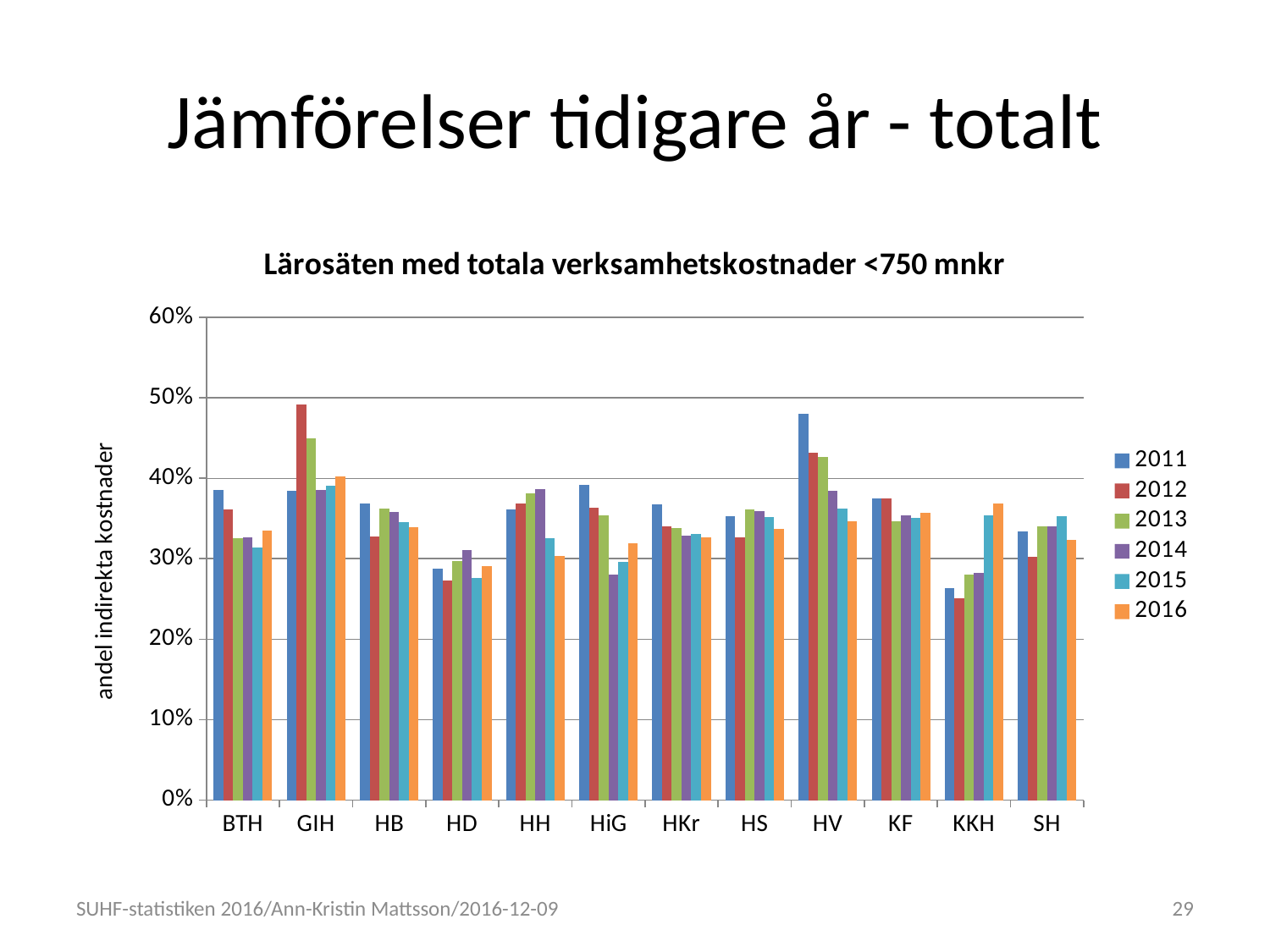
Is the 2012 value for GIH greater or less than 40%? greater Which institution has the lowest value in the 2016 series? HD For HV, do the values rise or fall from 2011 to 2016? fall Which institution has the highest value in the 2011 series? HV How many series does the legend list? 6 What is the label on the vertical axis? andel indirekta kostnader What kind of chart is shown on the slide? bar chart Is the 2011 value for KKH greater or less than 30%? less What is the title of the chart? Lärosäten med totala verksamhetskostnader <750 mnkr For HV, which is larger: the 2011 value or the 2016 value? 2011 Which institution has the highest value in the 2012 series? GIH How many institutions (categories) are shown on the x axis? 12